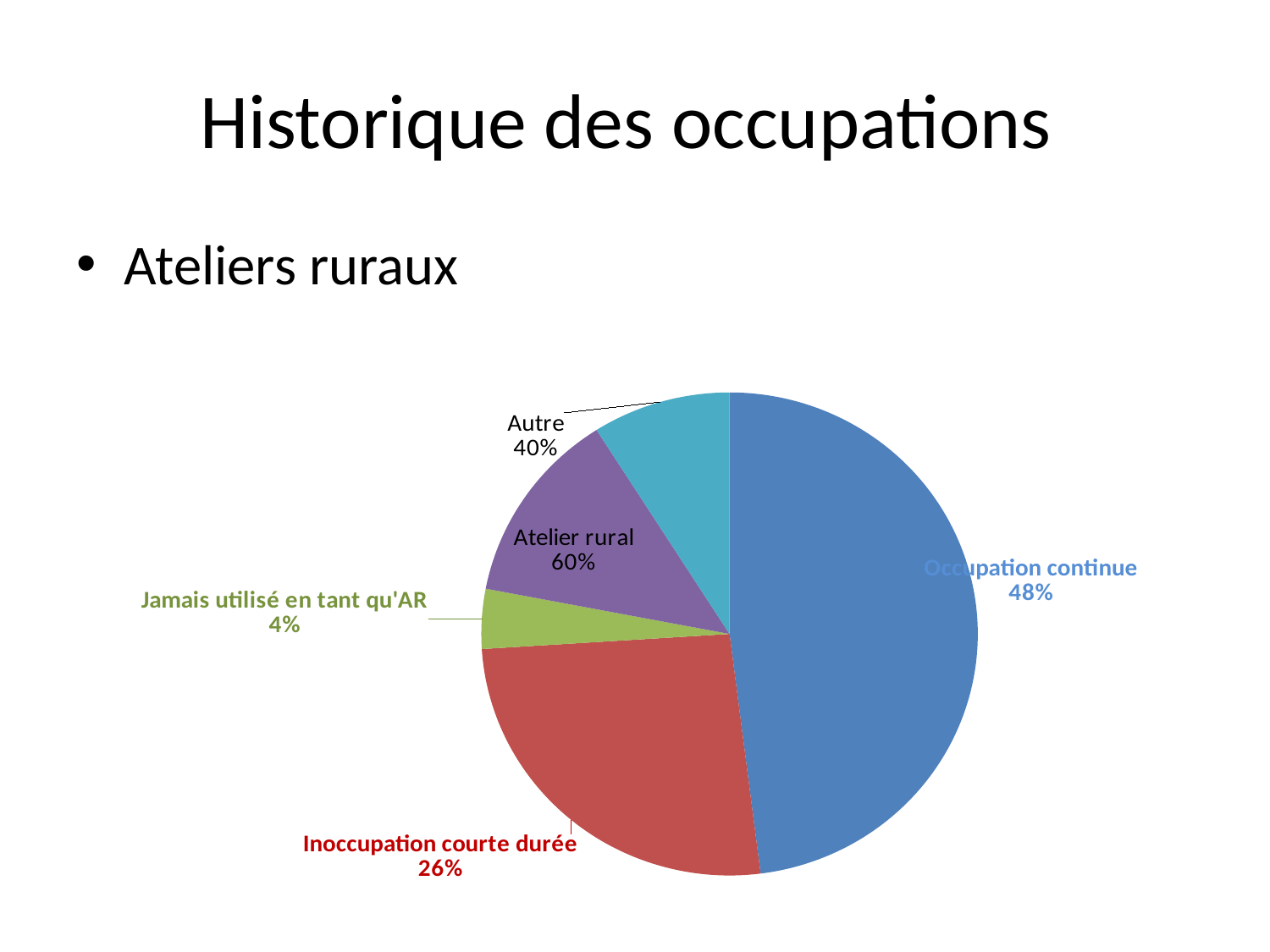
Which is larger in the pie chart: Occupation continue or Inoccupation courte durée? Occupation continue What is the title of the slide containing the pie chart? Historique des occupations What colour is the Inoccupation courte durée slice in the pie chart? Red What type of chart is shown on the slide? Pie chart What percentage is shown for Jamais utilisé en tant qu'AR in the pie chart? 4% What is the difference in percentage points between Occupation continue and Inoccupation courte durée? 22 percentage points How many slices does the pie chart have? 5 What percentage is shown for Inoccupation courte durée in the pie chart? 26% What percentage is shown for Occupation continue in the pie chart? 48% What percentage label is printed next to Atelier rural in the pie chart? 60% Which slice of the pie chart has the smallest share? Jamais utilisé en tant qu'AR What percentage label is printed next to Autre in the pie chart? 40%